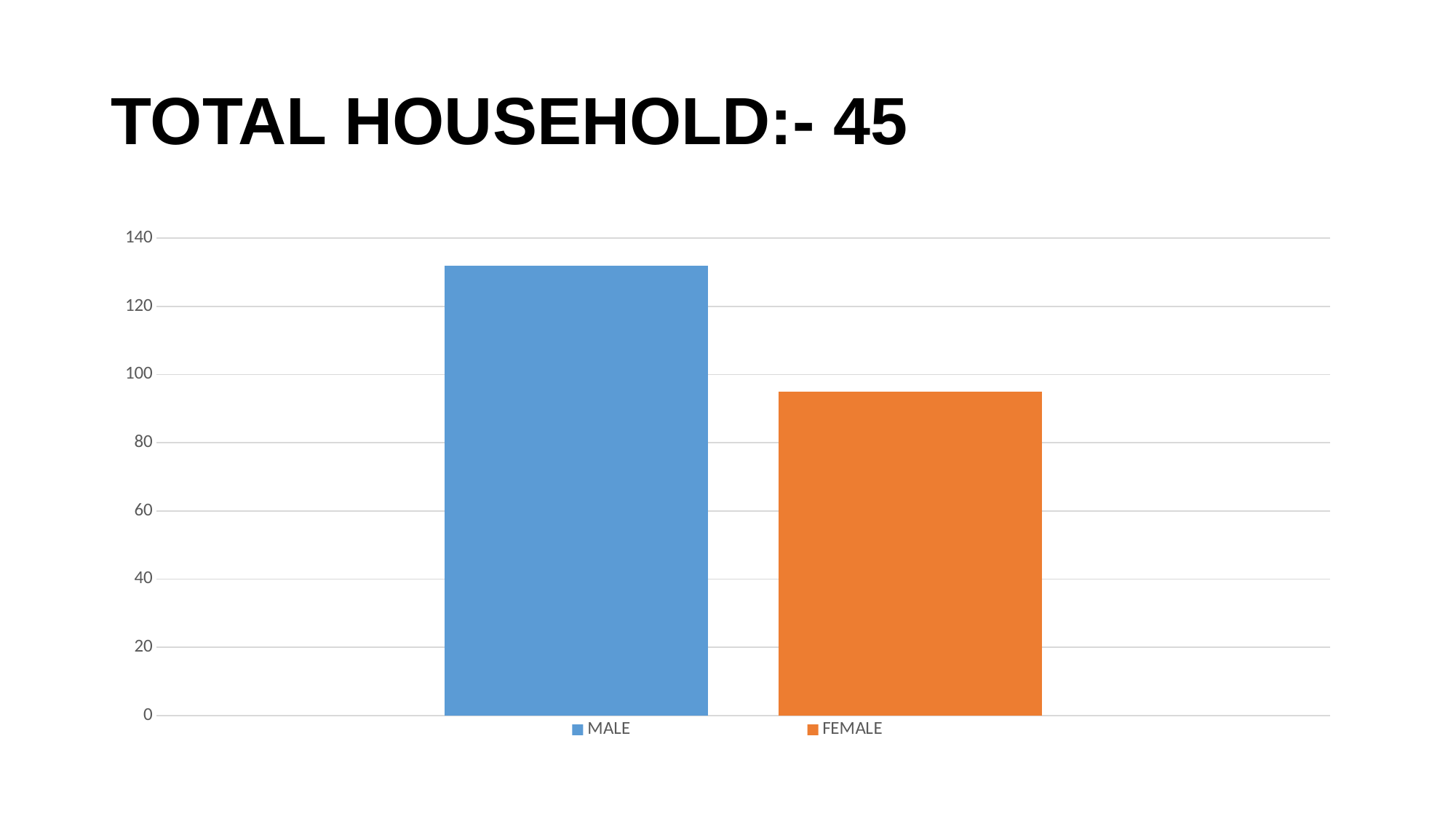
Is the value for FEMALE greater or less than 80? greater What colour is the bar for FEMALE? orange What is the title shown above the chart? TOTAL HOUSEHOLD:- 45 Which series has the lowest value? FEMALE Is the value for MALE greater or less than 120? greater How many bars are plotted in the chart? 2 How many series does the legend list? 2 What kind of chart is shown on the slide? bar chart Is the value for MALE larger or smaller than the value for FEMALE? larger Is the value for FEMALE greater or less than 100? less Which series has the highest value, MALE or FEMALE? MALE